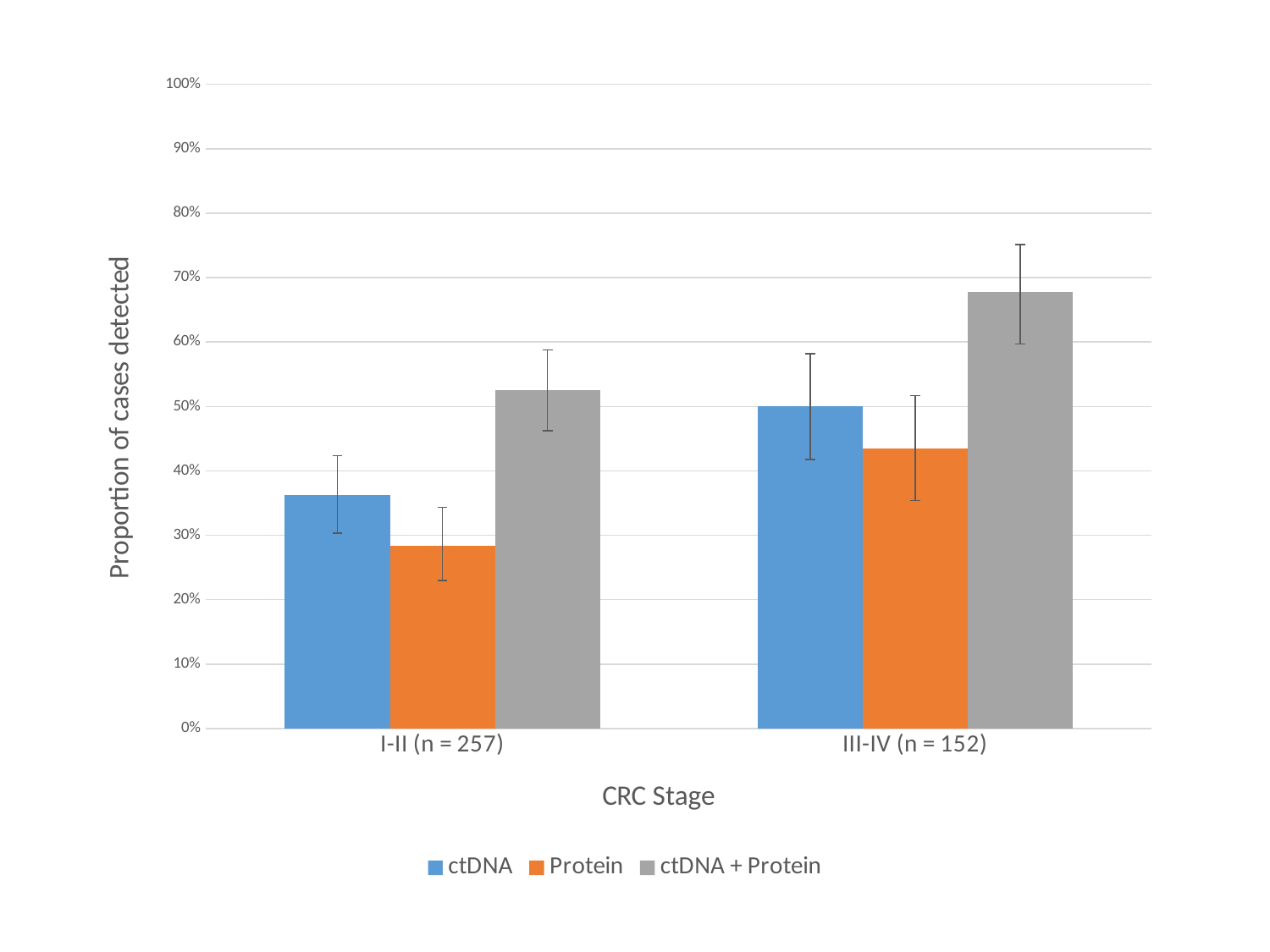
Which series has the lowest bar in the I-II (n = 257) category? Protein What kind of chart is shown on the slide? bar chart Which is larger for III-IV (n = 152): the ctDNA bar or the Protein bar? ctDNA Is the Protein value for I-II (n = 257) greater or less than 30%? less How many series does the legend list? 3 Which bar is the tallest on the whole chart? ctDNA + Protein for III-IV (n = 152) What is the title of the vertical axis? Proportion of cases detected Which series has the highest bar in the III-IV (n = 152) category? ctDNA + Protein How many CRC stage categories are shown on the x axis? 2 Do the ctDNA + Protein values rise or fall from I-II (n = 257) to III-IV (n = 152)? rise Is the ctDNA + Protein value for III-IV (n = 152) greater or less than 60%? greater Is the ctDNA value for I-II (n = 257) greater or less than 30%? greater